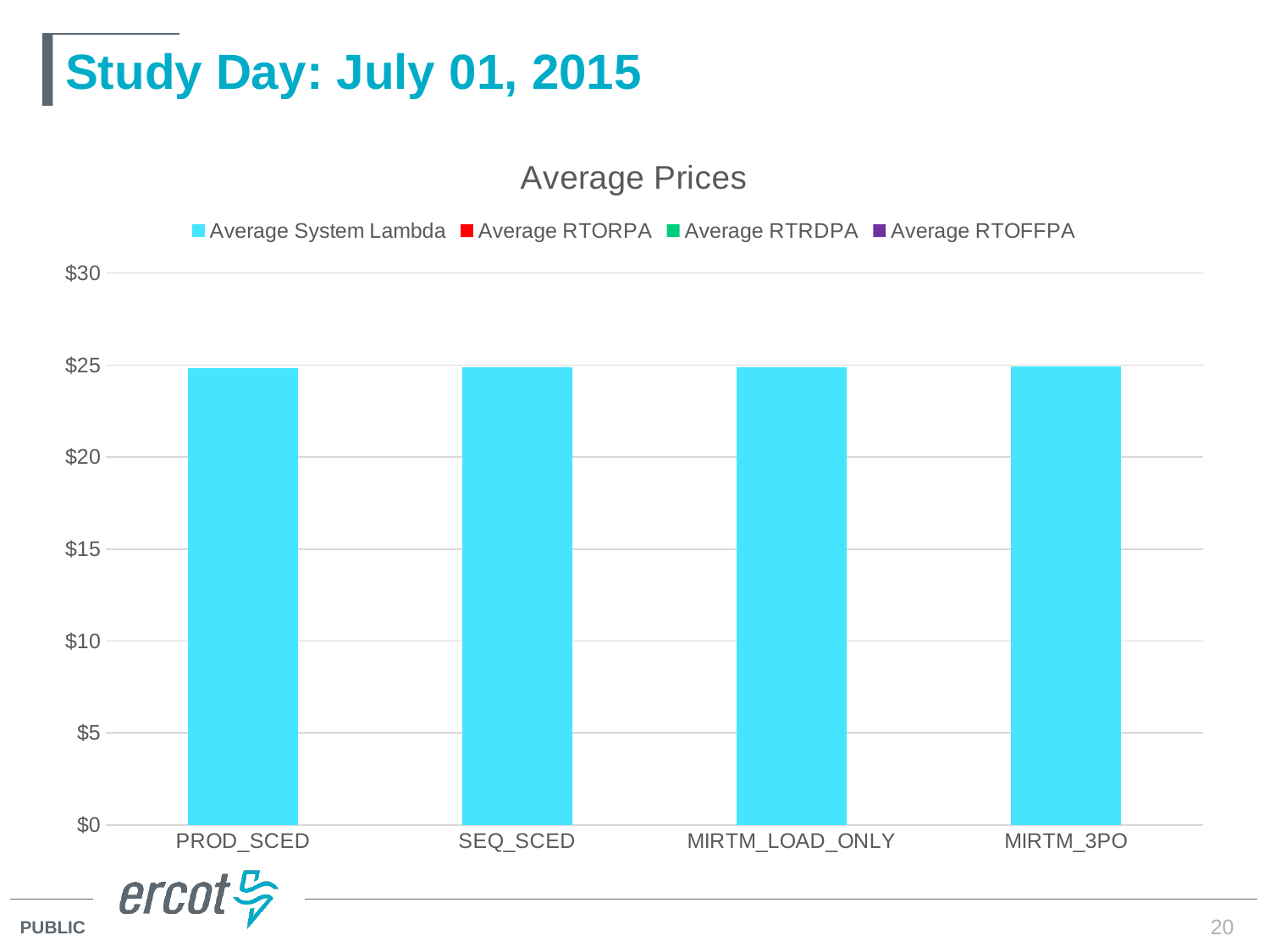
Which series is plotted in light blue according to the legend? Average System Lambda How many series does the chart's legend list? 4 How many categories are shown on the x axis of the chart? 4 What is the highest value shown on the y axis? $30 Is the value for PROD_SCED greater or less than $20? greater What is the label of the first category on the x axis? PROD_SCED Is the value for MIRTM_LOAD_ONLY greater or less than $15? greater Is the value for SEQ_SCED greater or less than $30? less What is the title of the chart? Average Prices What kind of chart is shown on the slide? bar chart